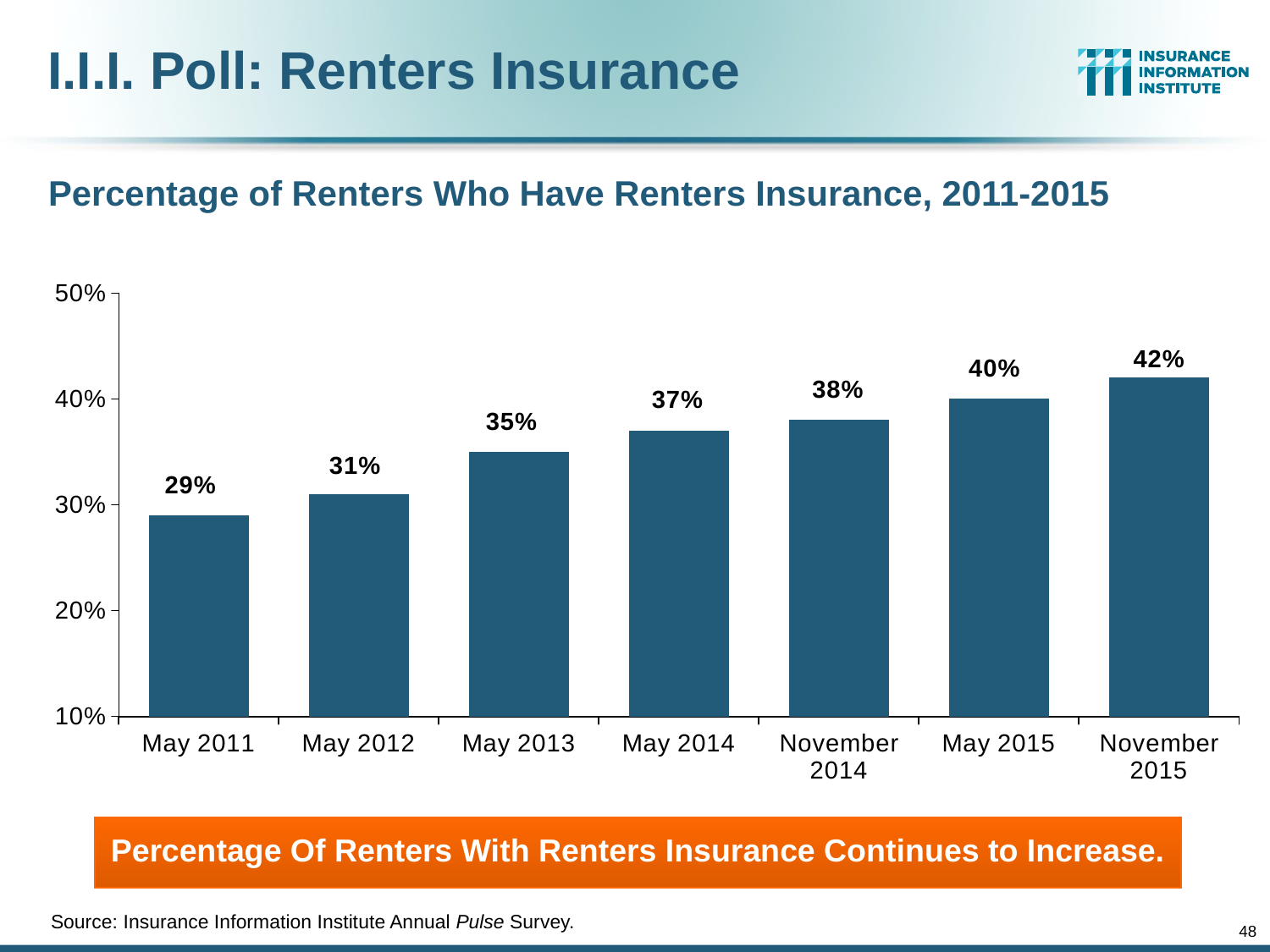
How many periods are shown on the x axis? 7 What is the difference between the May 2015 and May 2014 values? 3 percentage points Do the values rise or fall from May 2011 to November 2015? Rise What kind of chart is shown on the slide? Bar chart Which period has the lowest percentage of renters with renters insurance? May 2011 What is the difference in percentage points between November 2015 and May 2011? 13 percentage points Is the value for May 2015 greater or less than 30%? greater Which period has the highest percentage of renters with renters insurance? November 2015 Which is larger, the value for May 2012 or the value for May 2014? May 2014 What is the value shown for May 2013? 35% What is the value shown for November 2014? 38% What percentage of renters had renters insurance in May 2011? 29%